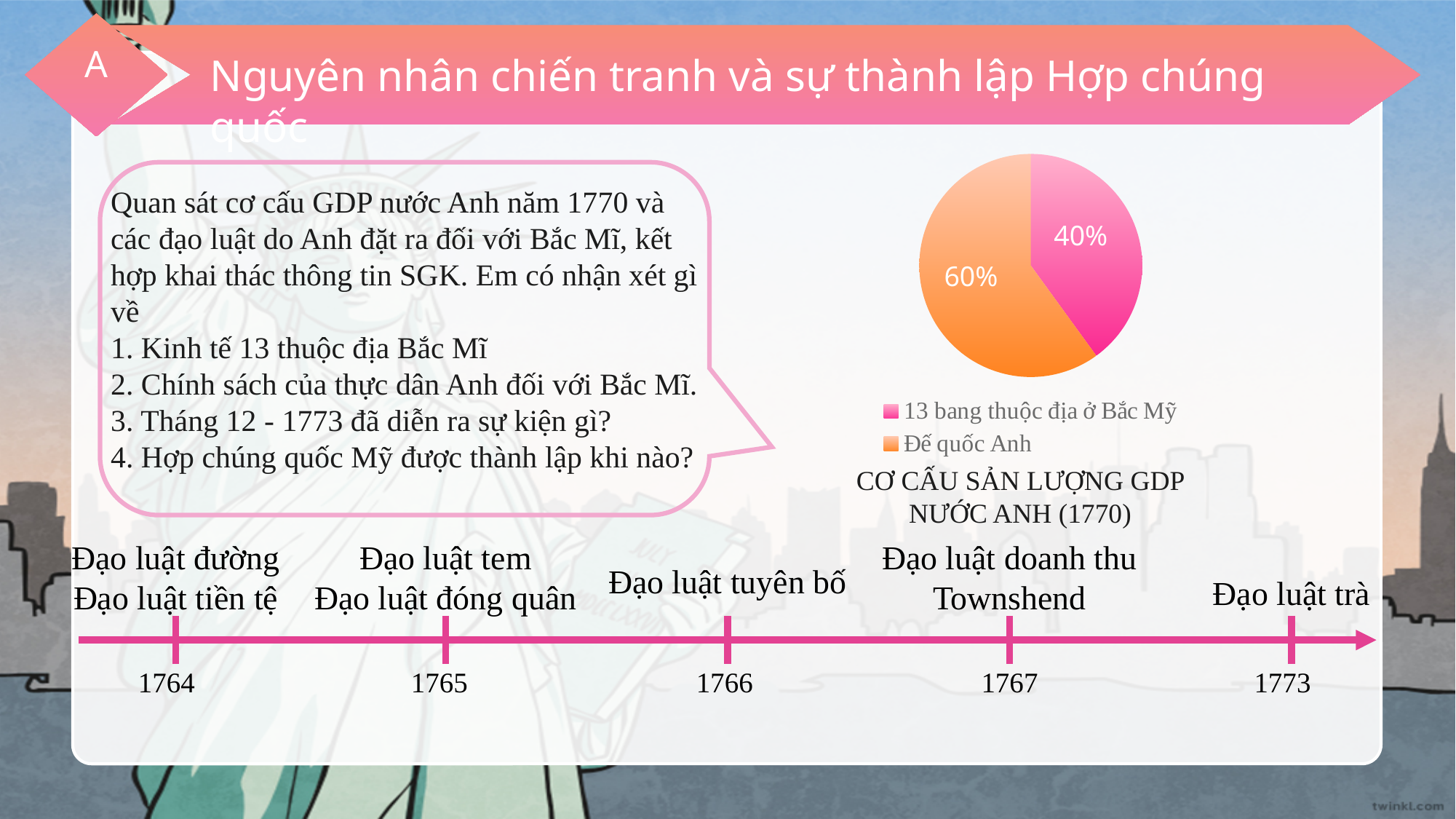
What share of the pie chart is labelled "Đế quốc Anh"? 60% Which is larger in the pie chart: "Đế quốc Anh" or "13 bang thuộc địa ở Bắc Mỹ"? Đế quốc Anh What is the title of the pie chart? CƠ CẤU SẢN LƯỢNG GDP NƯỚC ANH (1770) What share of the pie chart is labelled "13 bang thuộc địa ở Bắc Mỹ"? 40% What colour is the "Đế quốc Anh" slice in the pie chart? Orange What type of chart is shown on the slide? Pie chart Is the share for "13 bang thuộc địa ở Bắc Mỹ" greater or less than 50%? less Which slice of the pie chart is the largest? Đế quốc Anh What is the difference in percentage points between the "Đế quốc Anh" slice and the "13 bang thuộc địa ở Bắc Mỹ" slice? 20% How many entries does the pie chart legend list? 2 How many slices does the pie chart have? 2 Which slice of the pie chart is the smallest? 13 bang thuộc địa ở Bắc Mỹ